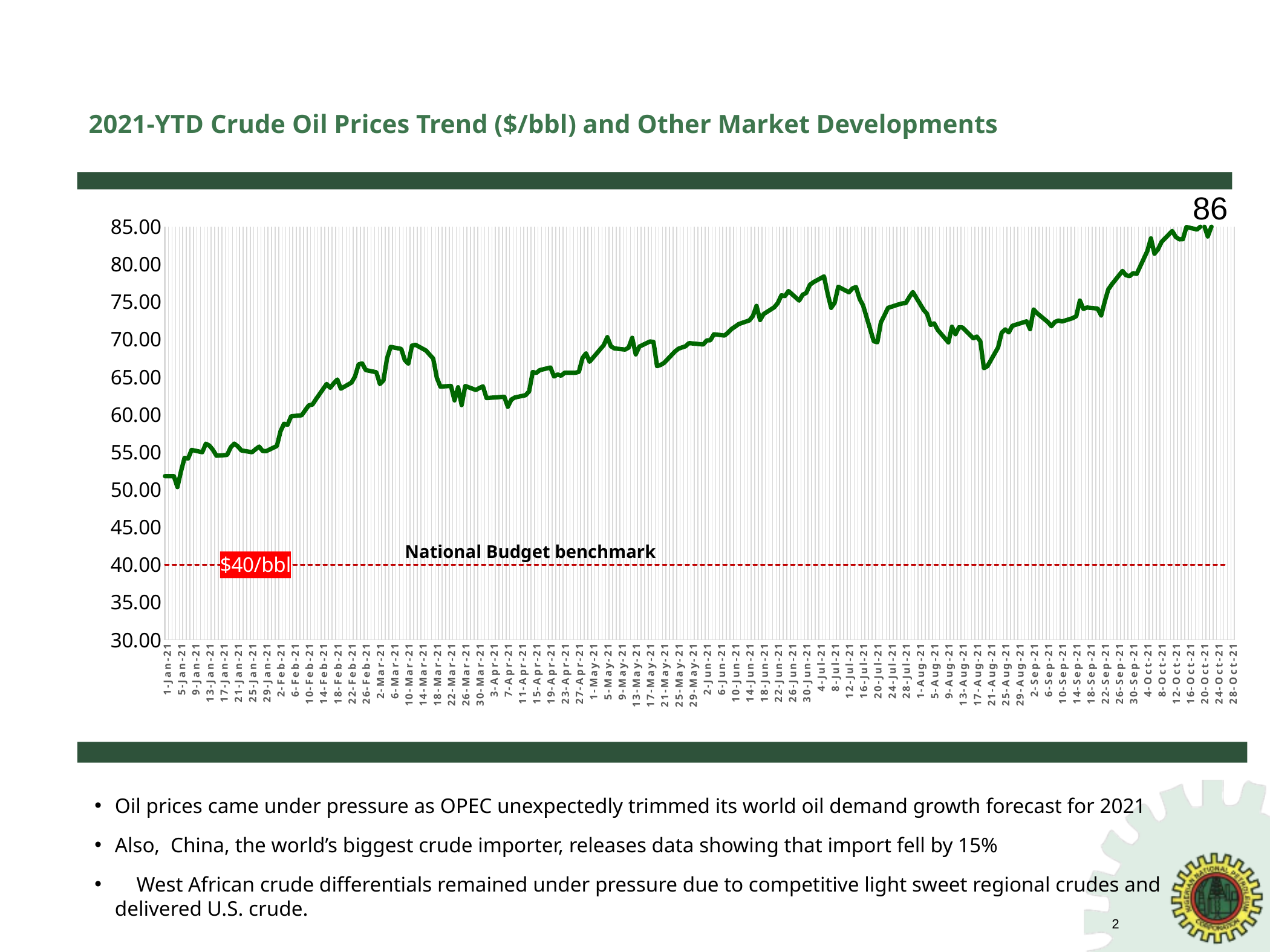
What is the value of the National Budget benchmark shown by the dashed line? $40/bbl What value is printed as a data label at the end of the line, near 20-Oct-21? 86 Overall, do crude oil prices rise or fall from January 2021 to October 2021? rise What is the title of the chart? 2021-YTD Crude Oil Prices Trend ($/bbl) and Other Market Developments Is the value around 2-Feb-21 greater or less than 60.00? less Which is larger, the value on 1-Jan-21 or the value on 20-Oct-21? 20-Oct-21 Is the value around 4-Jul-21 greater or less than 75.00? greater Is the lowest point on the line greater or less than 45.00? greater What kind of chart is shown on the slide? line chart Which is larger, the value around 4-Jul-21 or the value around 21-Aug-21? 4-Jul-21